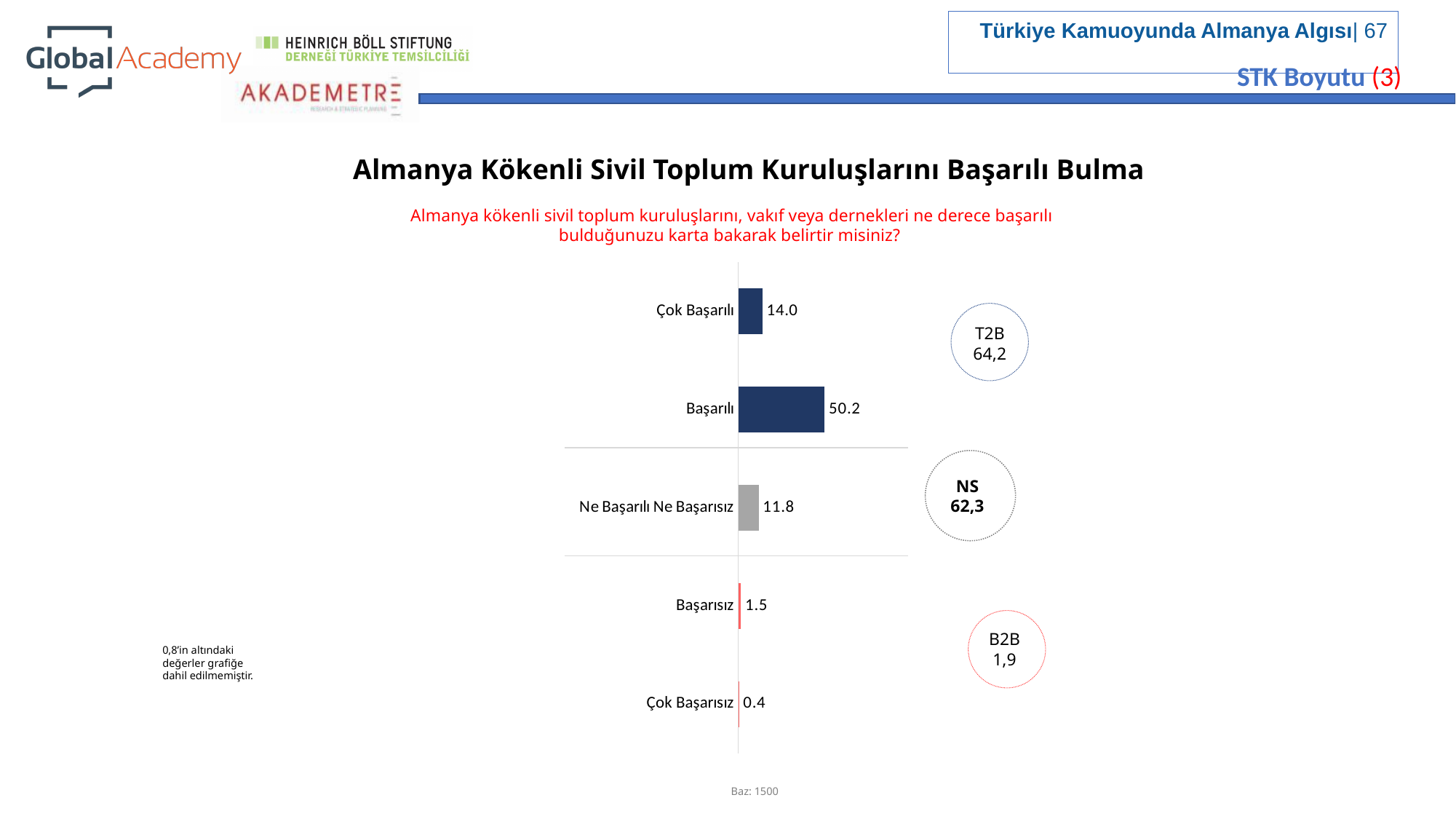
What is the value for Başarılı? 50.2 What is the value for Ne Başarılı Ne Başarısız? 11.8 What is the B2B value shown next to the chart? 1,9 What is the difference between the values for Başarılı and Çok Başarılı? 36.2 What is the T2B value shown next to the chart? 64,2 What is the value for Çok Başarısız? 0.4 How many categories are shown in the chart? 5 What kind of chart is shown on the slide? Bar chart What is the value for Çok Başarılı? 14.0 Which category has the highest value? Başarılı Which is larger, the value for Çok Başarılı or the value for Ne Başarılı Ne Başarısız? Çok Başarılı Which category has the lowest value? Çok Başarısız